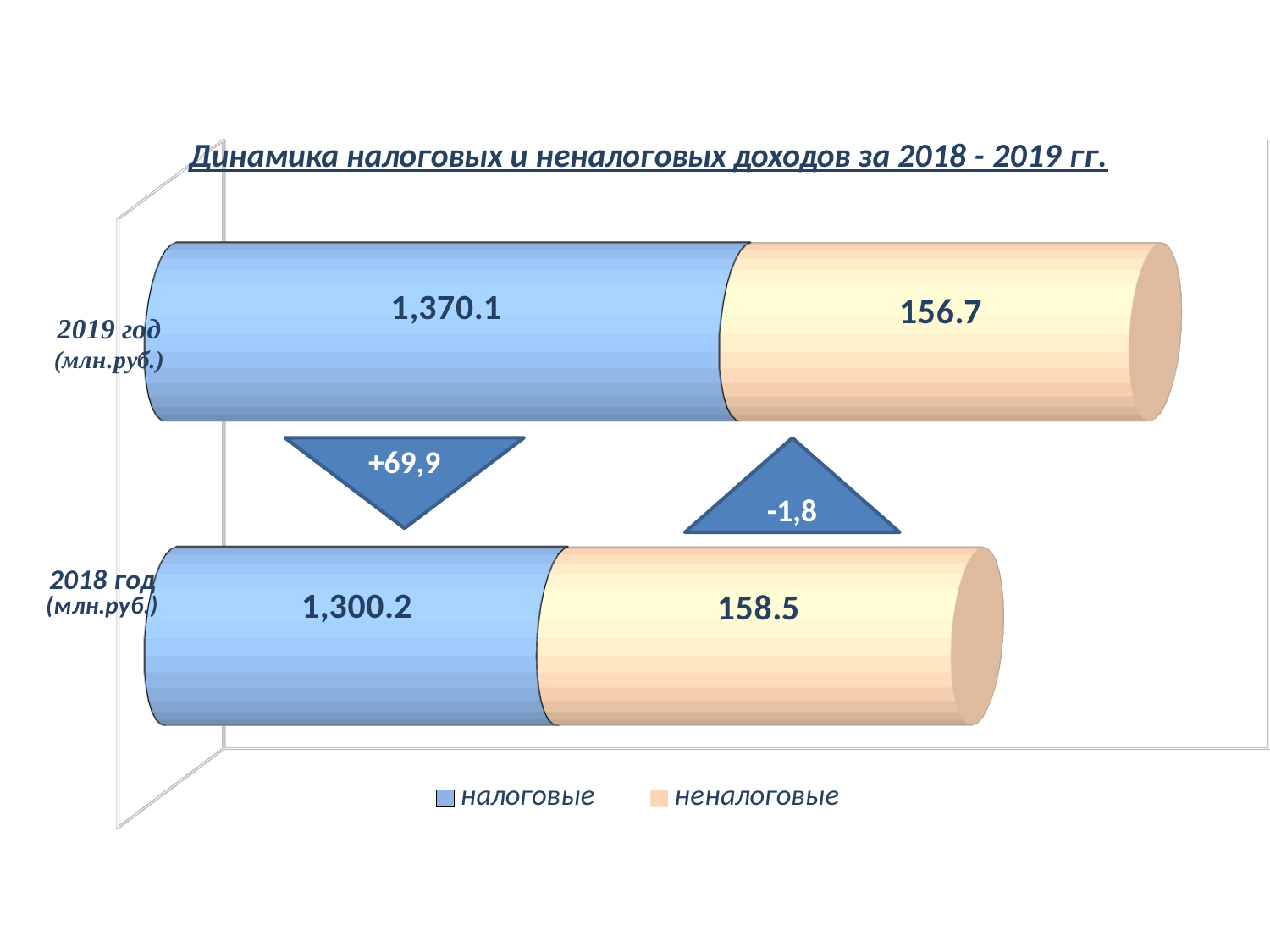
What is the value of налоговые for 2019 год? 1,370.1 What is the value of неналоговые for 2018 год? 158.5 What is the difference between the налоговые values for 2019 год and 2018 год? 69.9 What is the value of неналоговые for 2019 год? 156.7 What is the title of the chart? Динамика налоговых и неналоговых доходов за 2018 - 2019 гг. How many series does the legend list? 2 Which year has the higher value for налоговые? 2019 год What is the total of the stacked bar for 2019 год? 1,526.8 What is the total of the stacked bar for 2018 год? 1,458.7 What is the value of налоговые for 2018 год? 1,300.2 What kind of chart is shown on the slide? Stacked bar chart What is the difference between the неналоговые values for 2018 год and 2019 год? 1.8